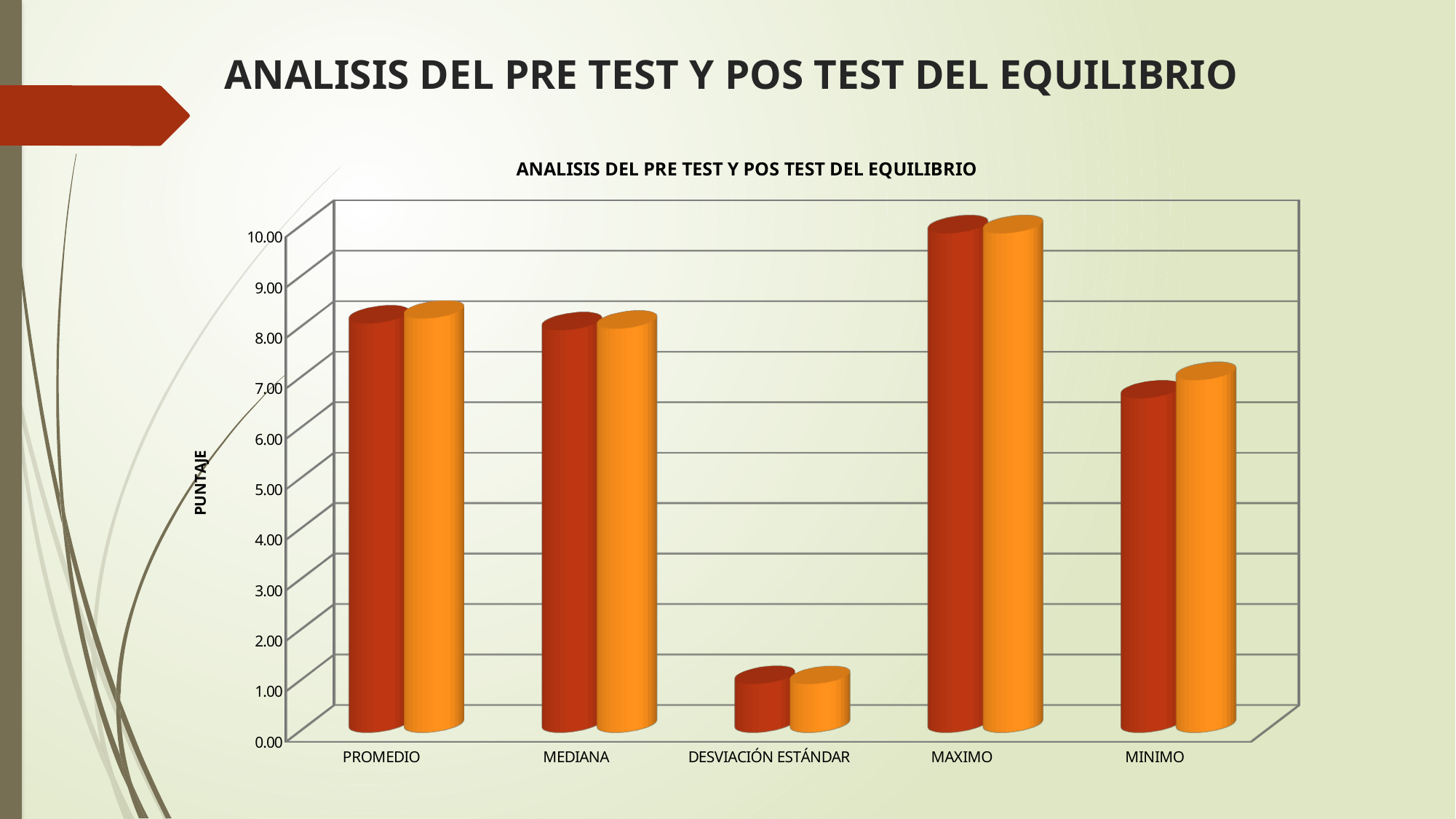
Is the value of the orange bar for PROMEDIO greater or less than 7.00? greater Which is larger, the orange bar for MAXIMO or the orange bar for MEDIANA? MAXIMO Which is larger, the dark red bar for PROMEDIO or the dark red bar for MINIMO? PROMEDIO How many categories are shown on the x axis of the chart? 5 Which category has the shortest bars in the chart? DESVIACIÓN ESTÁNDAR Which category has the tallest bars in the chart? MAXIMO Is the value of the dark red bar for MAXIMO greater or less than 9.00? greater What kind of chart is shown on the slide? bar chart What is the title of the chart? ANALISIS DEL PRE TEST Y POS TEST DEL EQUILIBRIO What is the label on the vertical axis of the chart? PUNTAJE Is the value of the dark red bar for MINIMO greater or less than 8.00? less